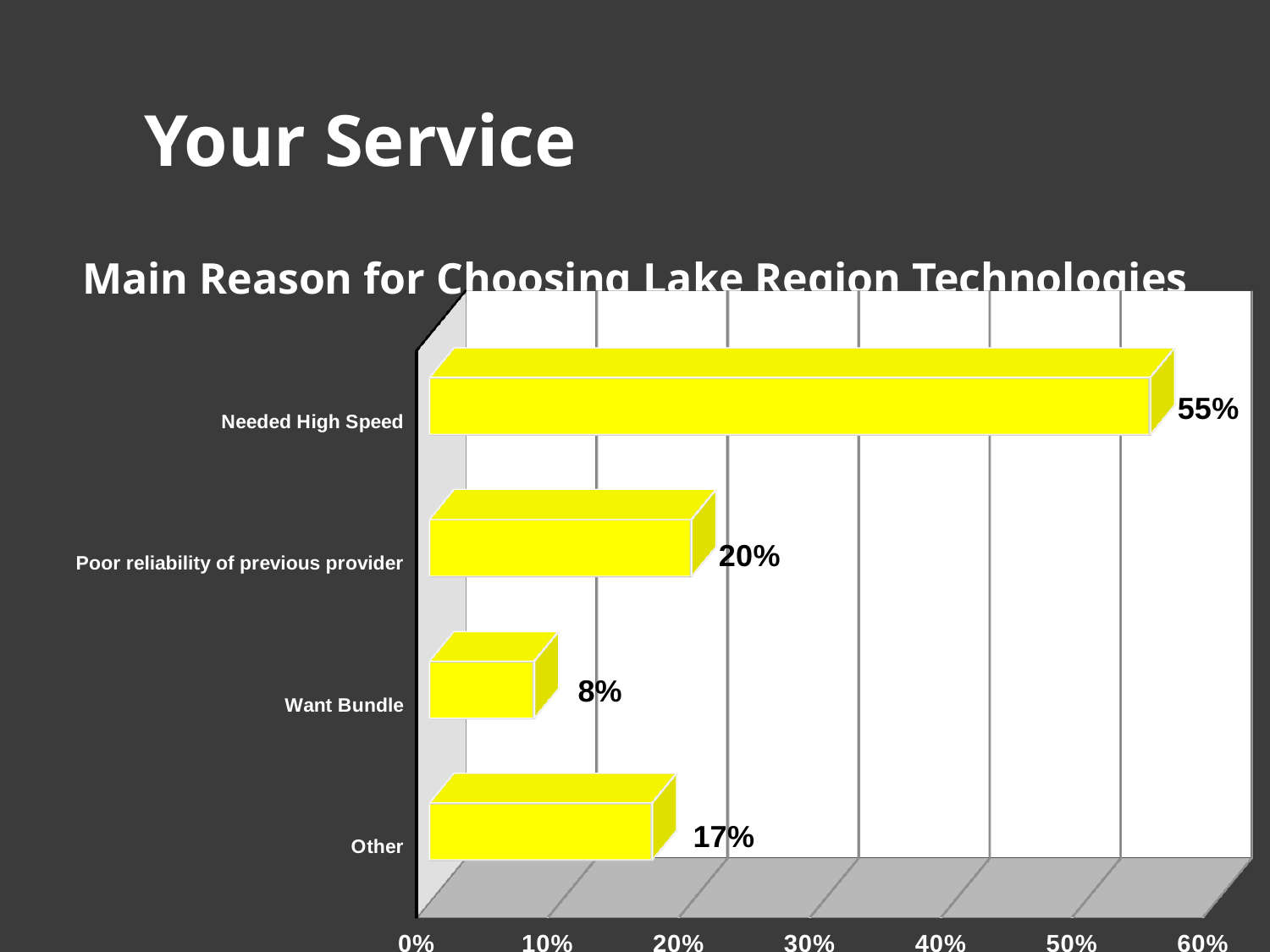
What is the difference between 'Other' and 'Want Bundle'? 9% What is the difference between 'Needed High Speed' and 'Poor reliability of previous provider'? 35% How many reasons (categories) are shown in the chart? 4 What is the value for 'Want Bundle'? 8% Which is larger, 'Poor reliability of previous provider' or 'Other'? Poor reliability of previous provider Which reason has the lowest percentage? Want Bundle What is the title of the chart? Main Reason for Choosing Lake Region Technologies Which reason has the highest percentage? Needed High Speed What kind of chart is shown on the slide? Bar chart What percentage of respondents chose Lake Region Technologies because they needed high speed? 55% What is the value for 'Poor reliability of previous provider'? 20% What is the value for 'Other'? 17%